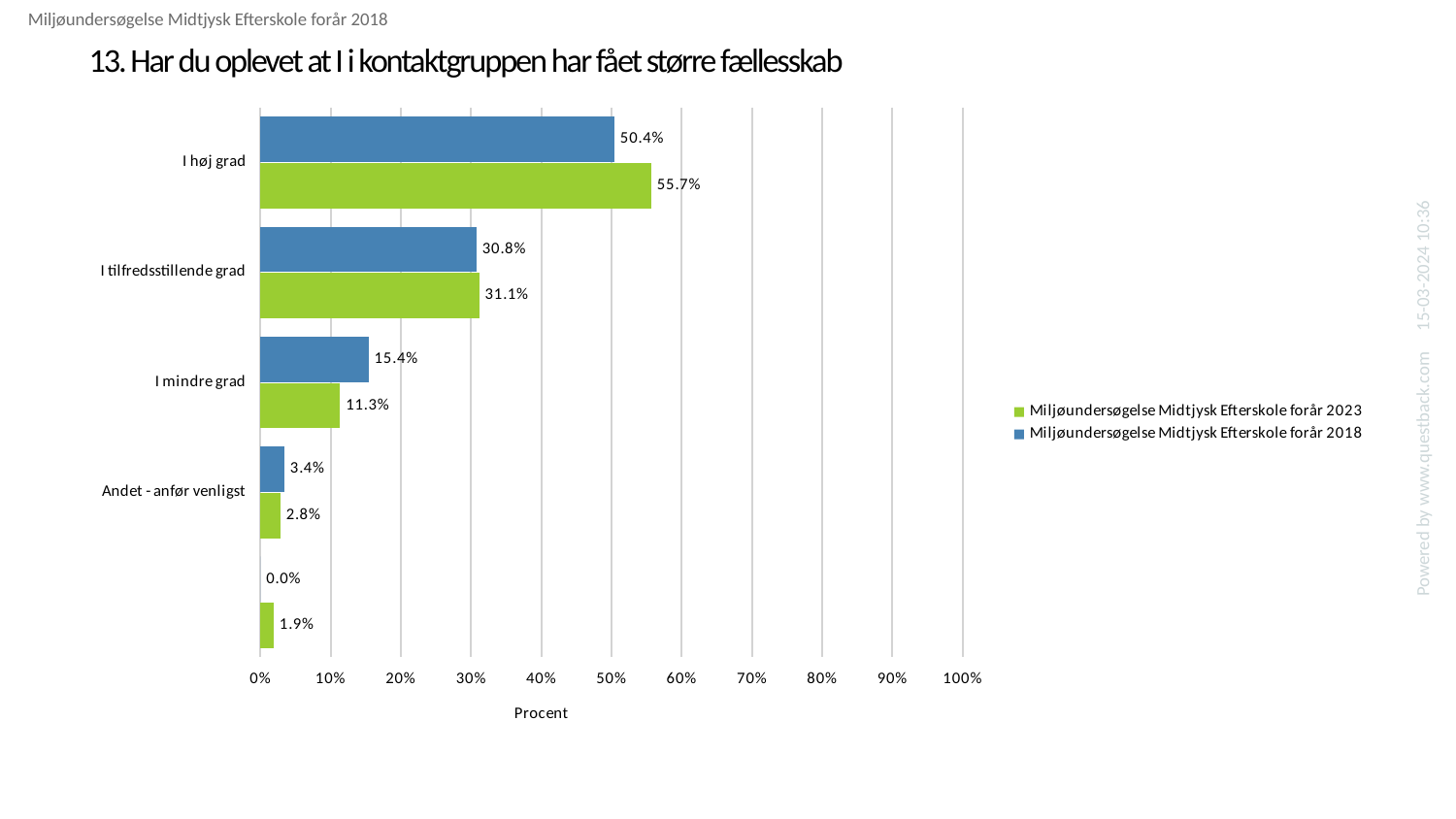
What is the value for 'I høj grad' in the Miljøundersøgelse Midtjysk Efterskole forår 2018 series? 50.4% How many series does the legend list? 2 Is the 2018 value for 'I tilfredsstillende grad' greater or less than 40%? less What colour represents the Miljøundersøgelse Midtjysk Efterskole forår 2023 series? green What is the difference between the 2023 and 2018 values for 'I tilfredsstillende grad'? 0.3 percentage points What is the 2018 value for 'Andet - anfør venligst'? 3.4% Which category has the highest value in the 2023 series? I høj grad What is the value for 'I høj grad' in the Miljøundersøgelse Midtjysk Efterskole forår 2023 series? 55.7% What kind of chart is shown on the slide? bar chart What is the 2023 value for 'I mindre grad'? 11.3% What is the difference between the 2023 and 2018 values for 'I høj grad'? 5.3 percentage points For 'I mindre grad', which series has the larger value, 2018 or 2023? 2018